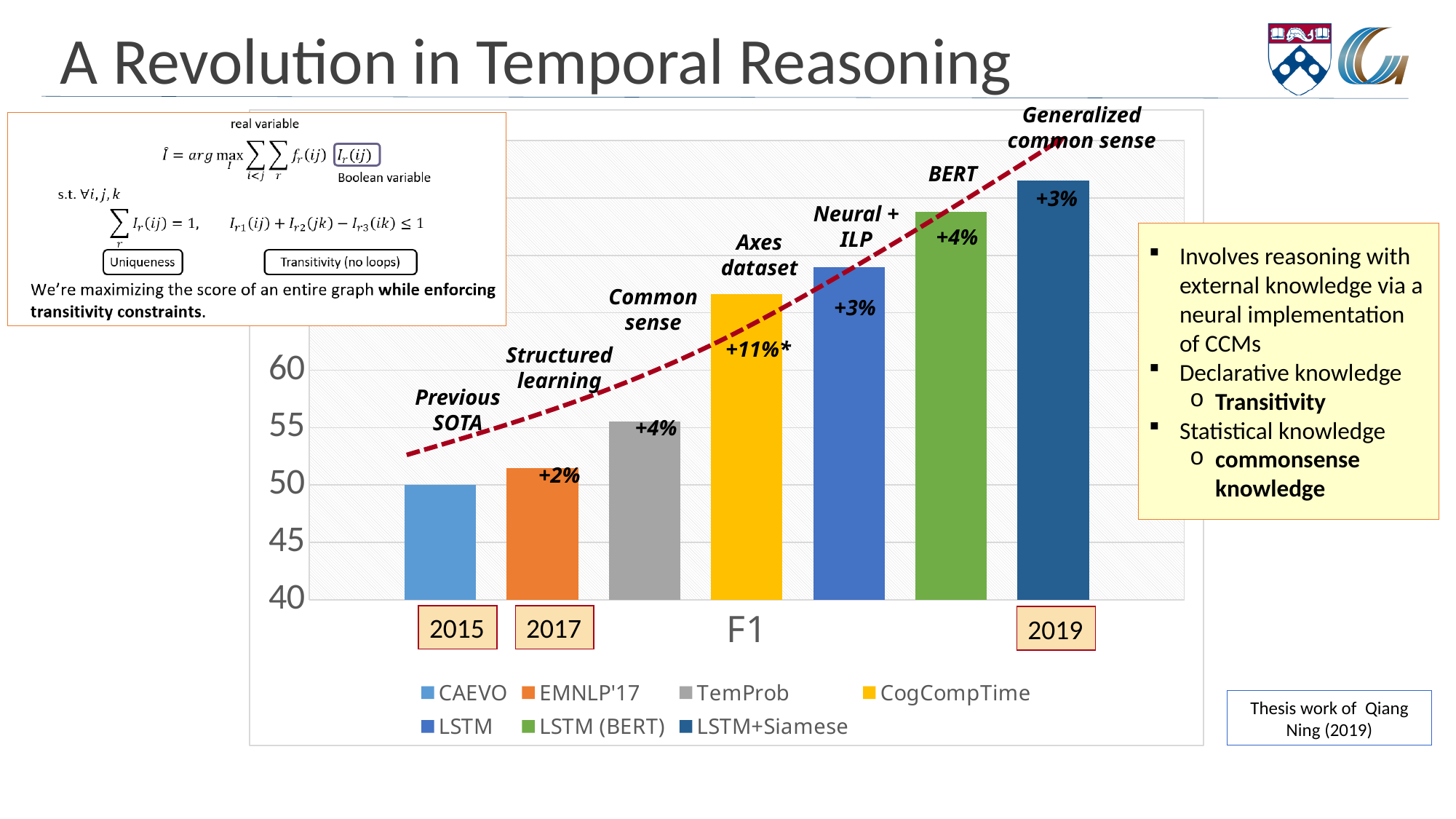
Which is larger, the F1 bar for TemProb or the F1 bar for EMNLP'17? TemProb Which is larger, the F1 bar for LSTM (BERT) or the F1 bar for CogCompTime? LSTM (BERT) Which series has the highest F1 bar? LSTM+Siamese What improvement label is printed on the CogCompTime bar? +11%* Do the bars rise or fall from left to right across the chart? rise Is the F1 value for EMNLP'17 greater or less than 55? less What kind of chart is shown on the slide? bar chart What is the category label shown on the x axis of the chart? F1 Is the F1 value for TemProb greater or less than 60? less How many series does the chart legend list? 7 Is the F1 value for CogCompTime greater or less than 60? greater Which series has the lowest F1 bar? CAEVO